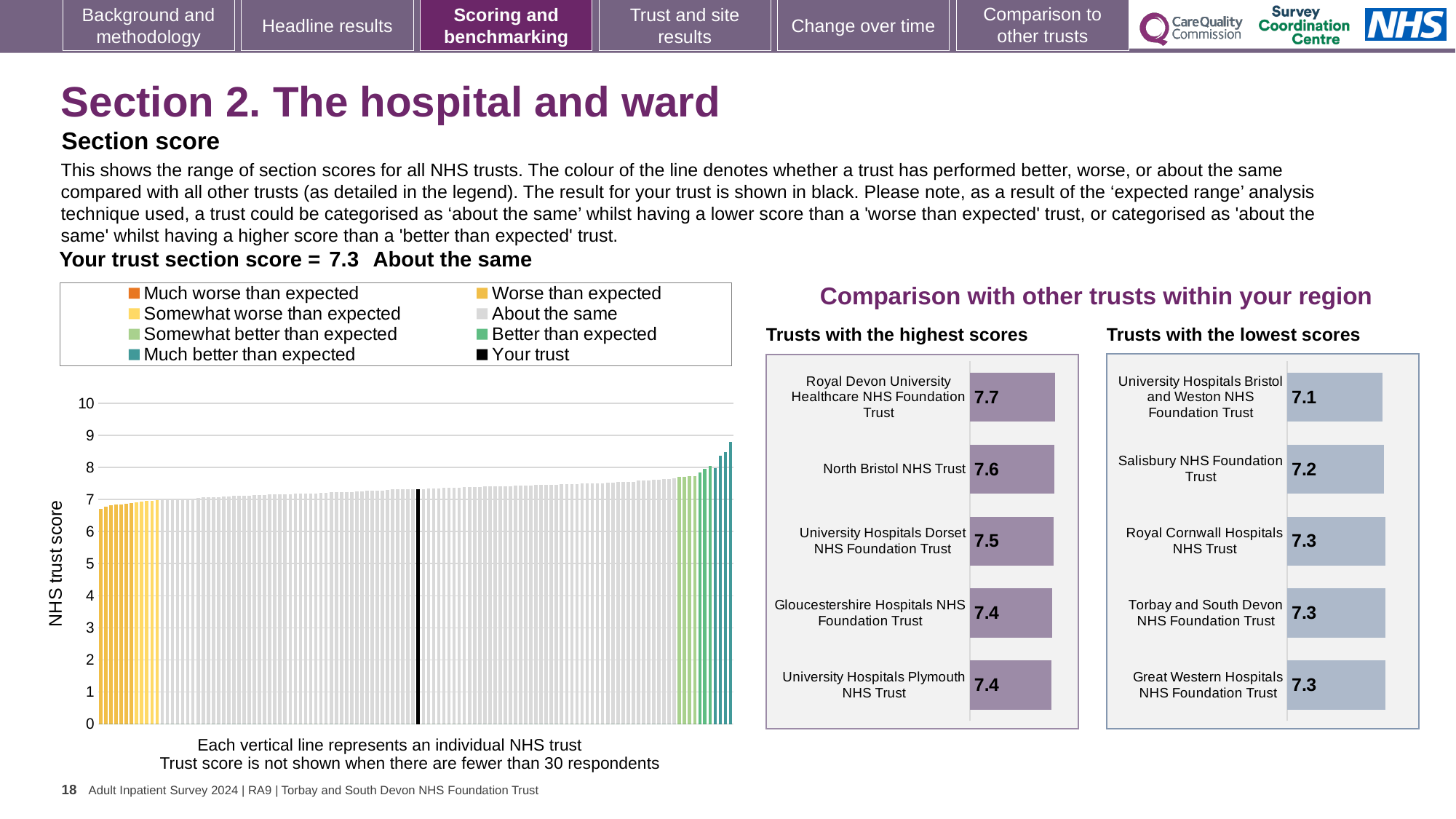
In the 'Trusts with the lowest scores' chart, what is the difference between the scores of Royal Cornwall Hospitals NHS Trust and University Hospitals Bristol and Weston NHS Foundation Trust? 0.2 In the 'Trusts with the highest scores' chart, what is the difference between the scores of Royal Devon University Healthcare NHS Foundation Trust and University Hospitals Plymouth NHS Trust? 0.3 In the 'Trusts with the lowest scores' chart, what is the score for Salisbury NHS Foundation Trust? 7.2 In the 'Trusts with the highest scores' chart, which has the higher score: North Bristol NHS Trust or University Hospitals Dorset NHS Foundation Trust? North Bristol NHS Trust In the large chart on the left showing all NHS trusts, is the value of the shortest bar greater or less than 7? less In the 'Trusts with the lowest scores' chart, how many trusts are listed? 5 In the 'Trusts with the lowest scores' chart, which trust has the lowest score? University Hospitals Bristol and Weston NHS Foundation Trust In the large chart on the left showing all NHS trusts, is the value of the tallest bar greater or less than 8? greater How many entries does the legend of the large chart on the left list? 8 What kind of chart is the large chart on the left showing all NHS trusts? bar chart In the 'Trusts with the highest scores' chart, which trust has the highest score? Royal Devon University Healthcare NHS Foundation Trust In the 'Trusts with the highest scores' chart, what is the score for North Bristol NHS Trust? 7.6